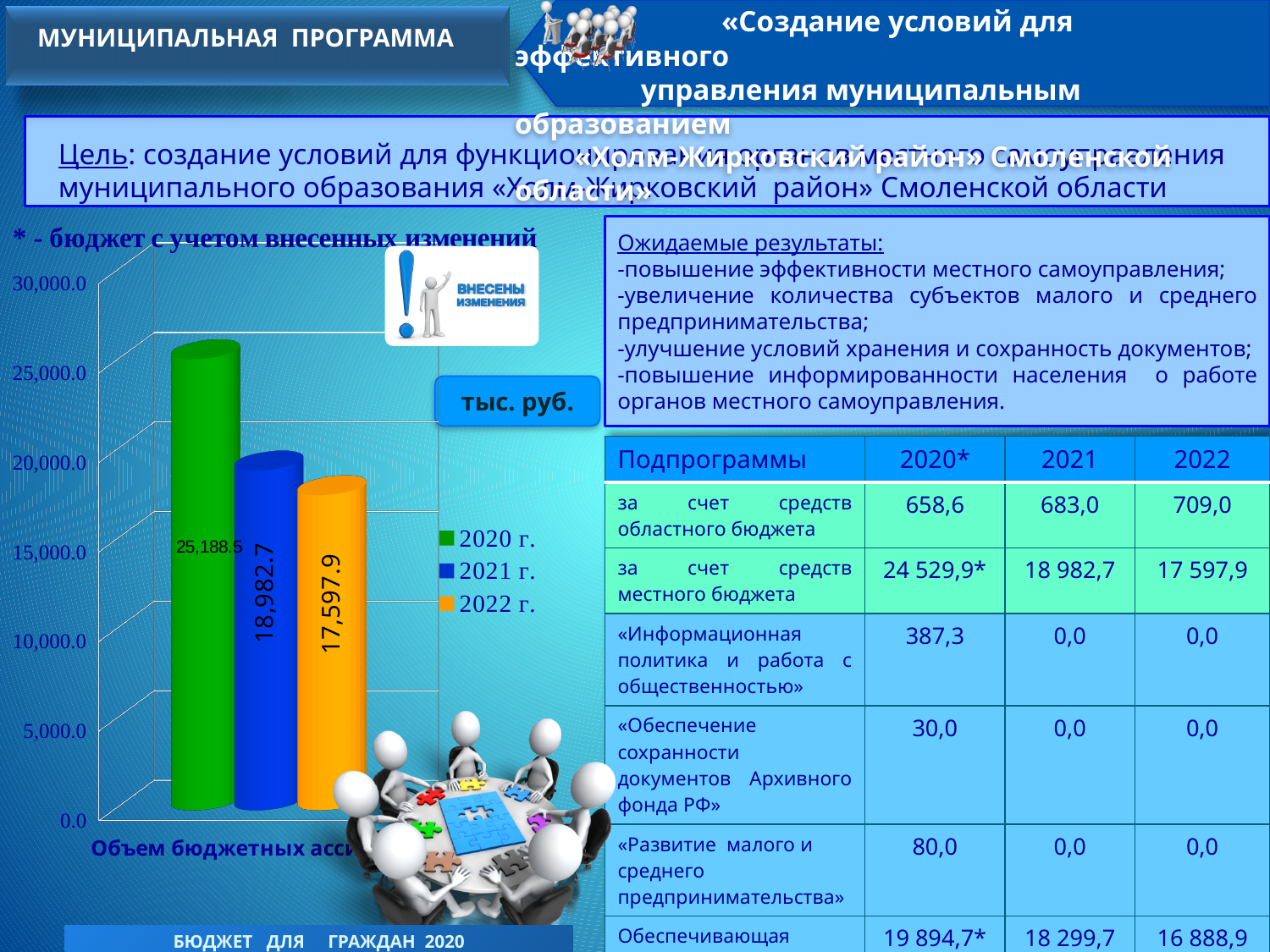
Which year has the highest value on the bar chart? 2020 г. Which is larger on the bar chart, the value for 2021 г. or the value for 2022 г.? 2021 г. How many bars are plotted on the bar chart? 3 What is the difference between the values for 2021 г. and 2022 г. on the bar chart? 1,384.8 What is the difference between the values for 2020 г. and 2021 г. on the bar chart? 6,205.8 Which year has the lowest value on the bar chart? 2022 г. Is the value for 2020 г. on the bar chart greater or less than 25,000.0? greater What is the value shown for 2021 г. on the bar chart? 18,982.7 What is the value shown for 2022 г. on the bar chart? 17,597.9 How many entries does the legend of the bar chart list? 3 What kind of chart is shown on the slide? bar chart What is the value shown for 2020 г. on the bar chart? 25,188.5